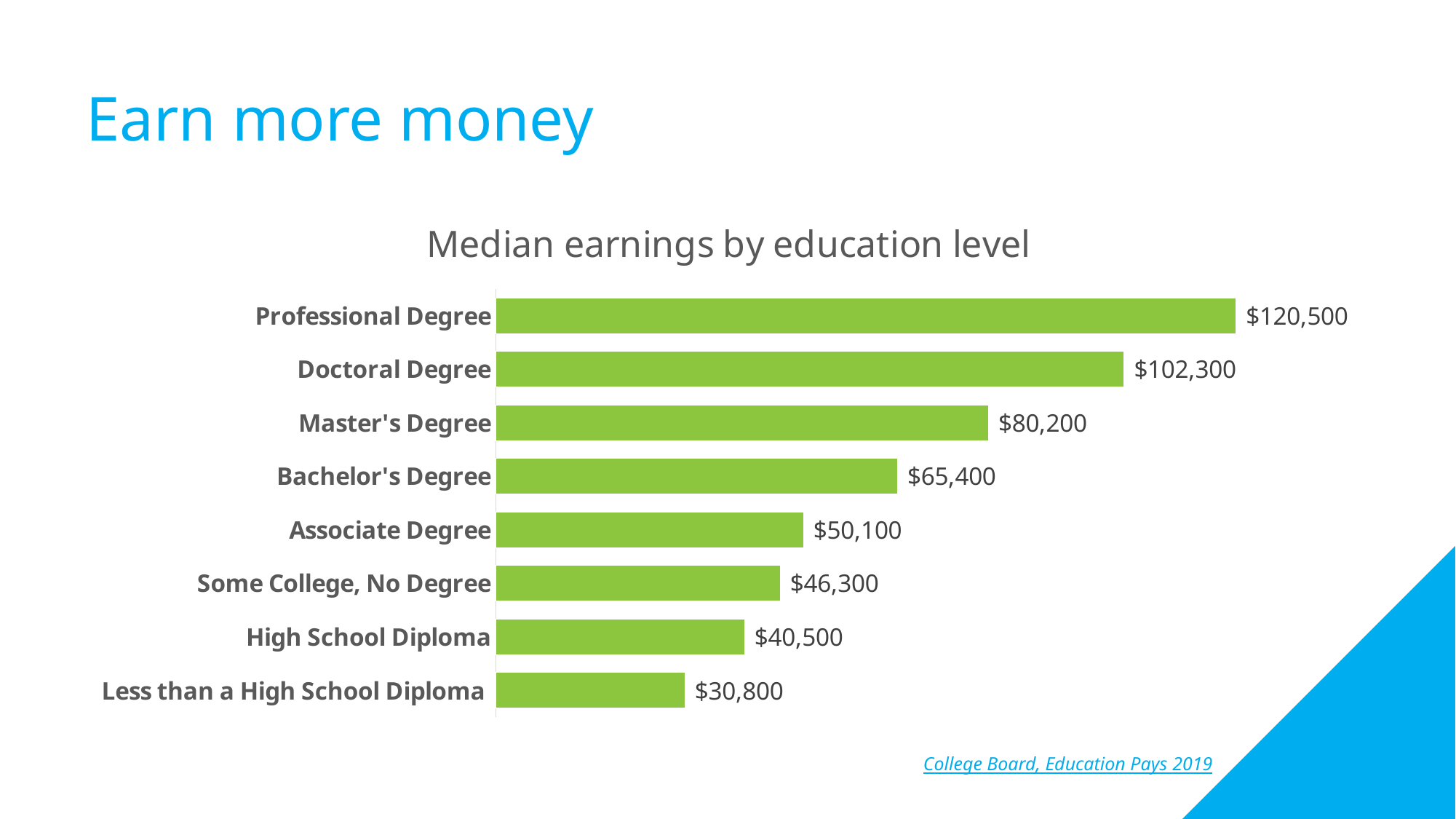
What kind of chart is shown on the slide? Bar chart What is the difference in median earnings between a Bachelor's Degree and a High School Diploma? $24,900 Which education level has the lowest median earnings? Less than a High School Diploma Which has higher median earnings, an Associate Degree or Some College, No Degree? Associate Degree What is the median earnings value for Some College, No Degree? $46,300 Which education level has the highest median earnings? Professional Degree What is the difference in median earnings between a Professional Degree and a Doctoral Degree? $18,200 How many education levels are shown in the chart? 8 What is the title of the chart? Median earnings by education level What colour are the bars in the chart? Green What is the median earnings value for Less than a High School Diploma? $30,800 What is the median earnings value for a Master's Degree? $80,200